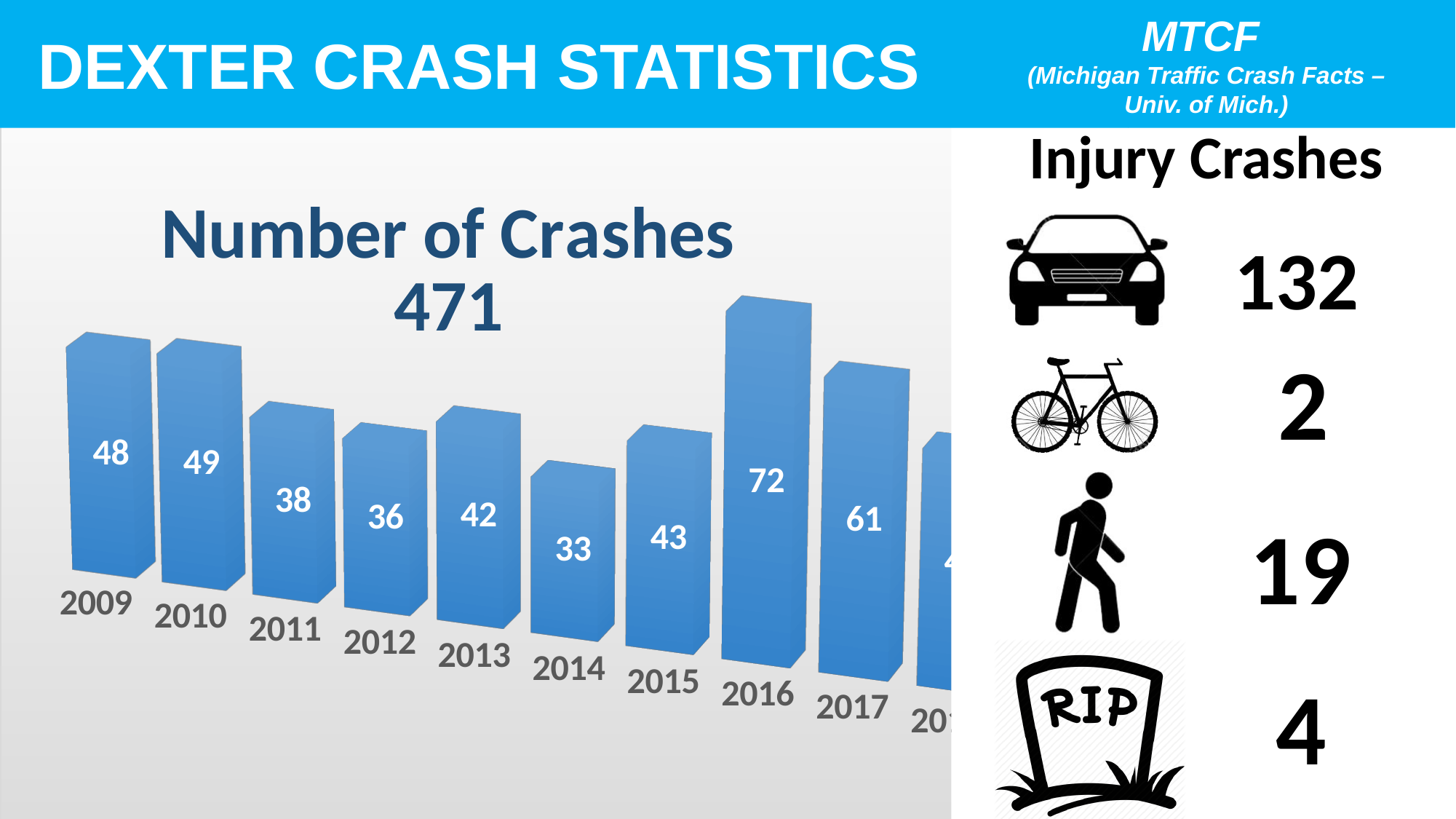
What is the number of crashes shown for 2017? 61 What is the number of crashes shown for 2014? 33 Which year from 2009 to 2017 has the lowest number of crashes? 2014 What is the title of the chart? Number of Crashes 471 What kind of chart is used to show the number of crashes? bar chart What is the number of crashes shown for 2011? 38 What is the difference in the number of crashes between 2009 and 2014? 15 What is the number of crashes shown for 2016? 72 What is the difference in the number of crashes between 2016 and 2017? 11 Which year from 2009 to 2017 has the highest number of crashes? 2016 Which year had more crashes, 2009 or 2010? 2010 Which year had more crashes, 2012 or 2013? 2013